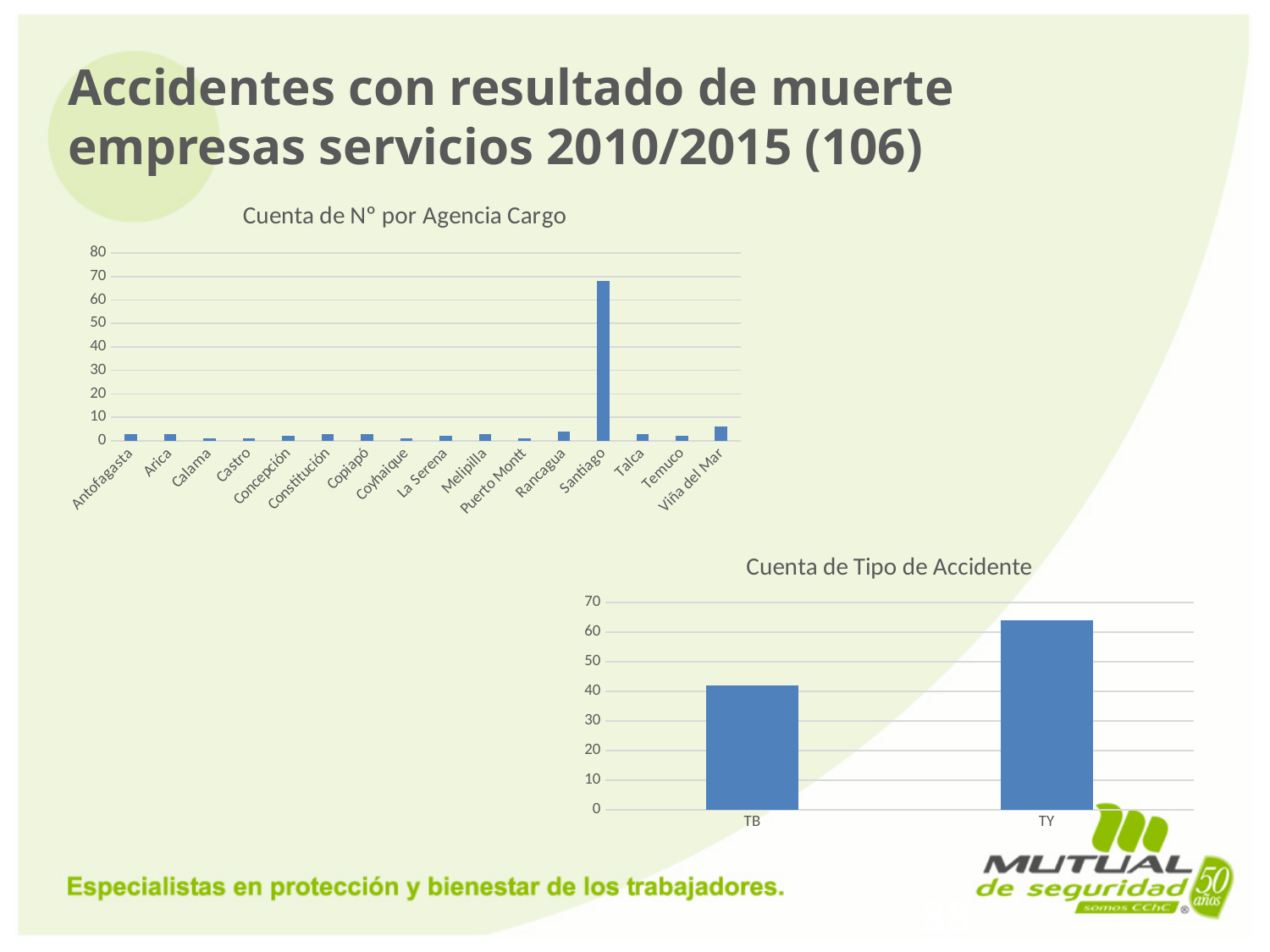
In the chart titled "Cuenta de Tipo de Accidente", is the value for TB greater or less than 50? less In the chart titled "Cuenta de Tipo de Accidente", how many categories are shown? 2 In the chart titled "Cuenta de Tipo de Accidente", is the value for TY greater or less than 60? greater In the chart titled "Cuenta de N° por Agencia Cargo", how many agencies are shown on the x axis? 16 In the chart titled "Cuenta de N° por Agencia Cargo", is the value for Viña del Mar greater or less than 10? less In the chart titled "Cuenta de Tipo de Accidente", what kind of chart is shown? bar chart In the chart titled "Cuenta de Tipo de Accidente", which category has the highest value? TY In the chart titled "Cuenta de N° por Agencia Cargo", what is the highest value shown on the y axis? 80 In the chart titled "Cuenta de N° por Agencia Cargo", which agency has the highest value? Santiago In the chart titled "Cuenta de N° por Agencia Cargo", what kind of chart is shown? bar chart In the chart titled "Cuenta de N° por Agencia Cargo", which is larger, the value for Santiago or the value for Rancagua? Santiago